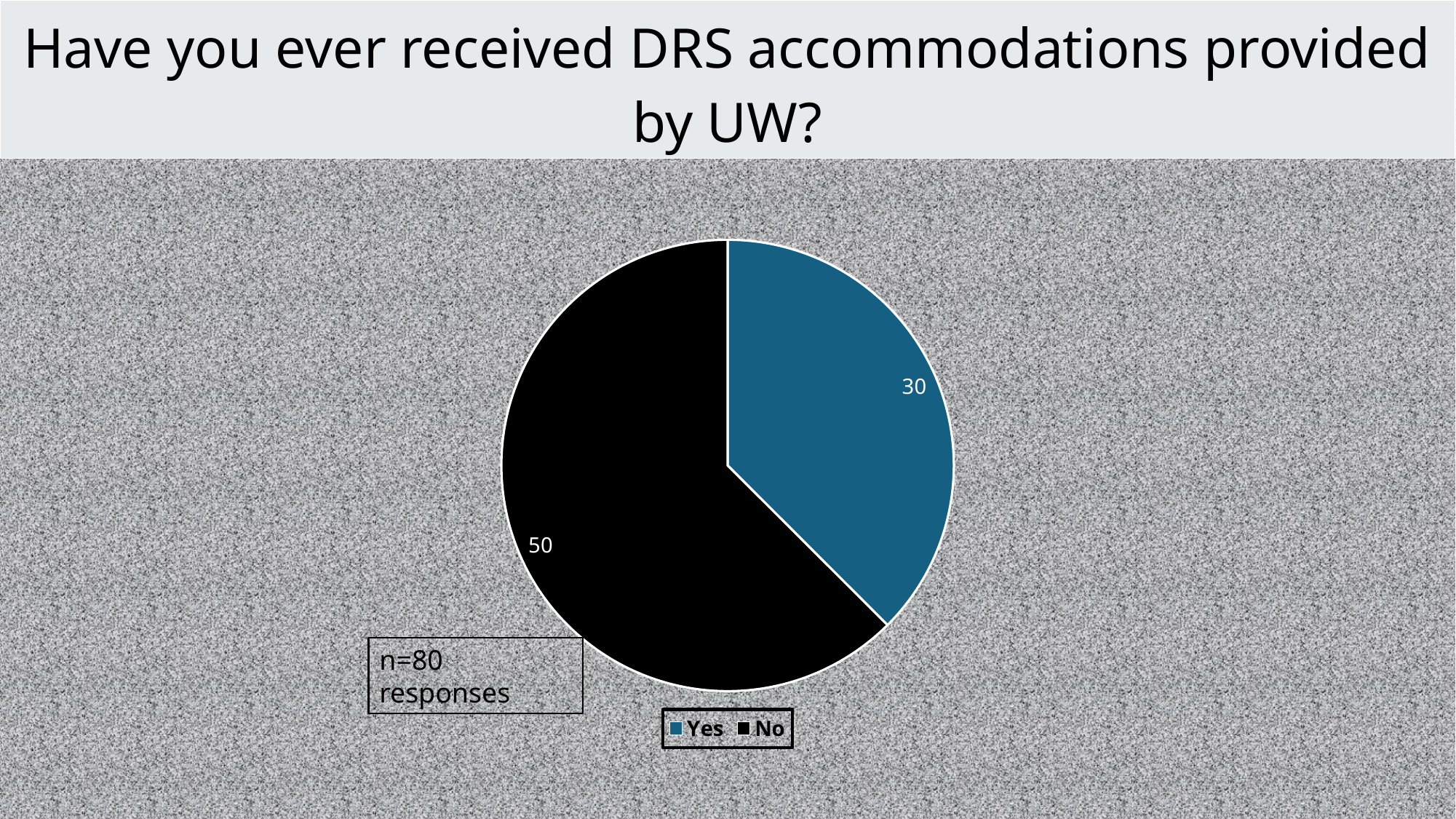
Which is larger, Yes or No? No What share of the pie does the No slice represent? 62.5% Which category has the smallest slice? Yes What kind of chart is shown on the slide? pie chart What is the difference between the No and Yes values? 20 What is the value for No? 50 What is the value for Yes? 30 How many slices does the pie chart have? 2 Which category has the largest slice? No What is the total of the two slices? 80 How many entries does the legend list? 2 What colour is the Yes slice? blue